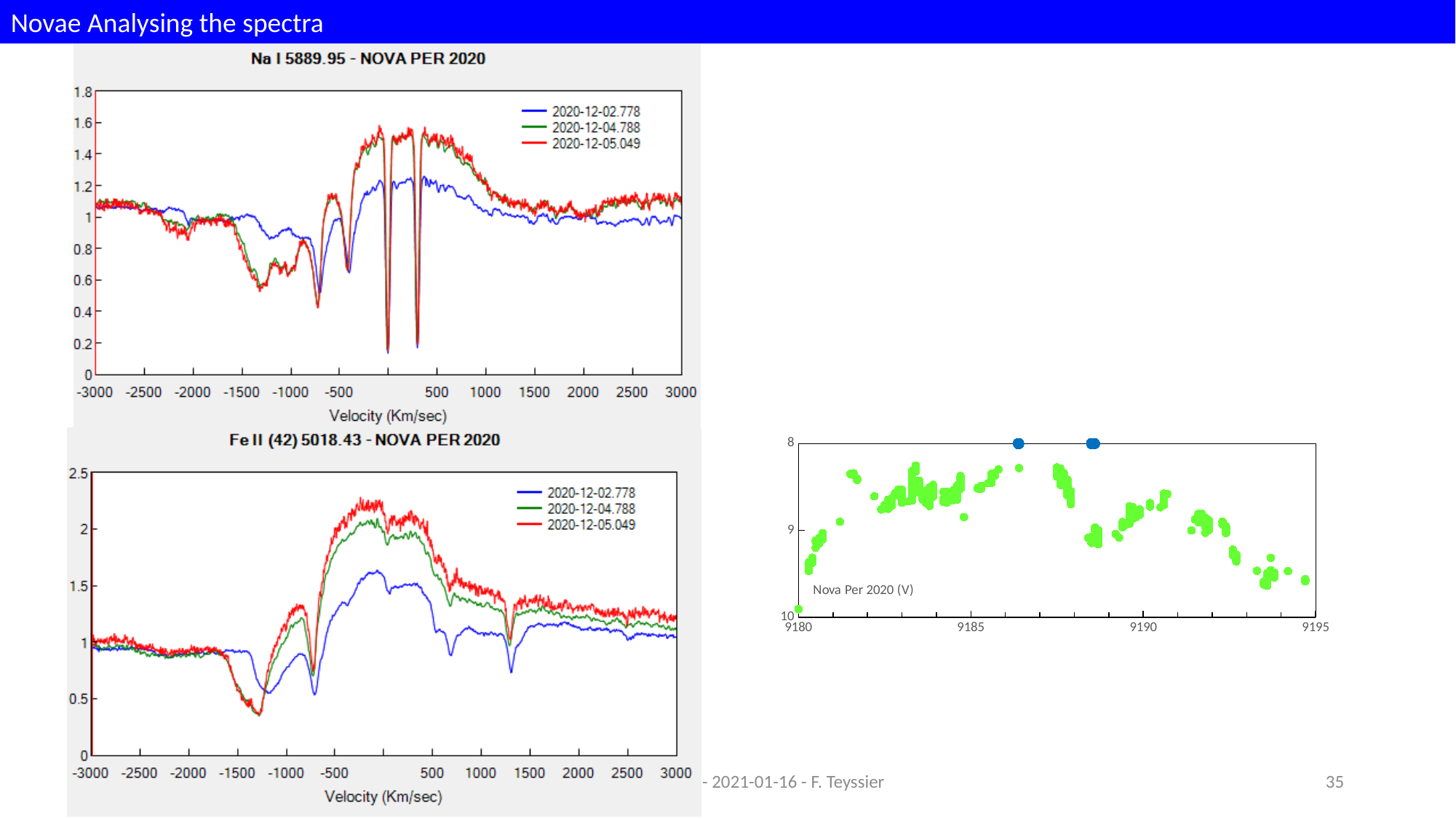
How many series does the legend list in the 'Fe II (42) 5018.43 - NOVA PER 2020' chart? 3 In the 'Fe II (42) 5018.43 - NOVA PER 2020' chart, is the peak value of the red 2020-12-05.049 line greater or less than 2? greater What kind of chart is the 'Nova Per 2020 (V)' chart on the right of the slide? scatter chart In the 'Fe II (42) 5018.43 - NOVA PER 2020' chart, which line reaches a higher peak, the red 2020-12-05.049 line or the blue 2020-12-02.778 line? 2020-12-05.049 In the 'Fe II (42) 5018.43 - NOVA PER 2020' chart, is the peak value of the blue 2020-12-02.778 line greater or less than 2? less In the 'Fe II (42) 5018.43 - NOVA PER 2020' chart, is the minimum of the red line near -1300 Km/sec greater or less than 0.5? less How many series does the legend list in the 'Na I 5889.95 - NOVA PER 2020' chart? 3 What kind of chart is the top-left chart titled 'Na I 5889.95 - NOVA PER 2020'? line chart In the 'Na I 5889.95 - NOVA PER 2020' chart, which date does the blue line represent? 2020-12-02.778 What is the x-axis label of the 'Fe II (42) 5018.43 - NOVA PER 2020' chart? Velocity (Km/sec)